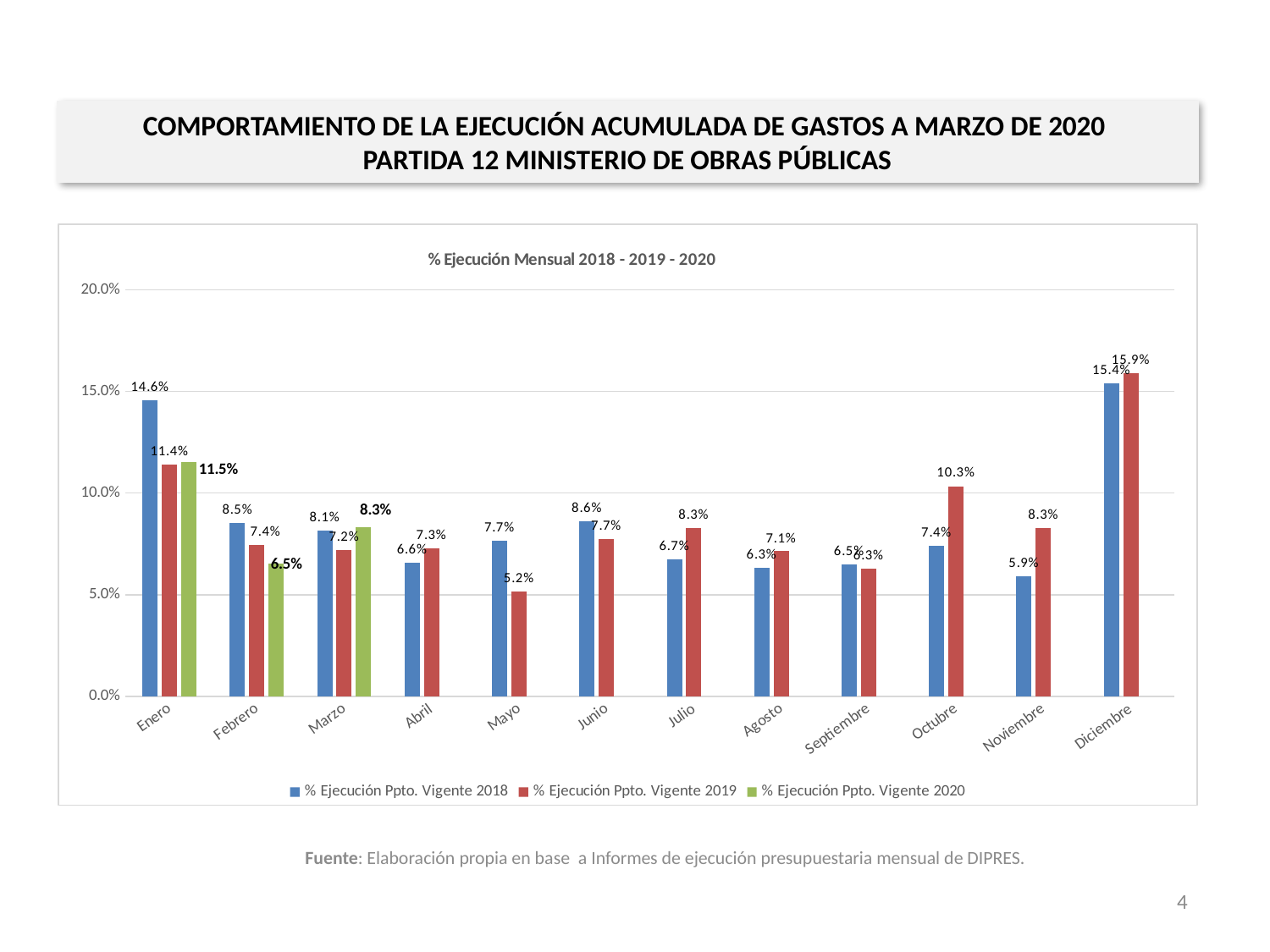
Is the value for Diciembre in the 2019 series greater or less than 15.0%? greater How many months are shown on the x axis? 12 Which month has the highest value in the % Ejecución Ppto. Vigente 2019 series? Diciembre What kind of chart is shown on the slide? bar chart What is the value for Octubre in the % Ejecución Ppto. Vigente 2019 series? 10.3% What is the title of the chart? % Ejecución Mensual 2018 - 2019 - 2020 What is the value for Enero in the % Ejecución Ppto. Vigente 2018 series? 14.6% How many series does the legend list? 3 What is the difference between the 2018 and 2019 values for Mayo? 2.5% Which is larger for Julio: the 2018 value or the 2019 value? 2019 What is the value for Marzo in the % Ejecución Ppto. Vigente 2020 series? 8.3% Which month has the lowest value in the % Ejecución Ppto. Vigente 2018 series? Noviembre